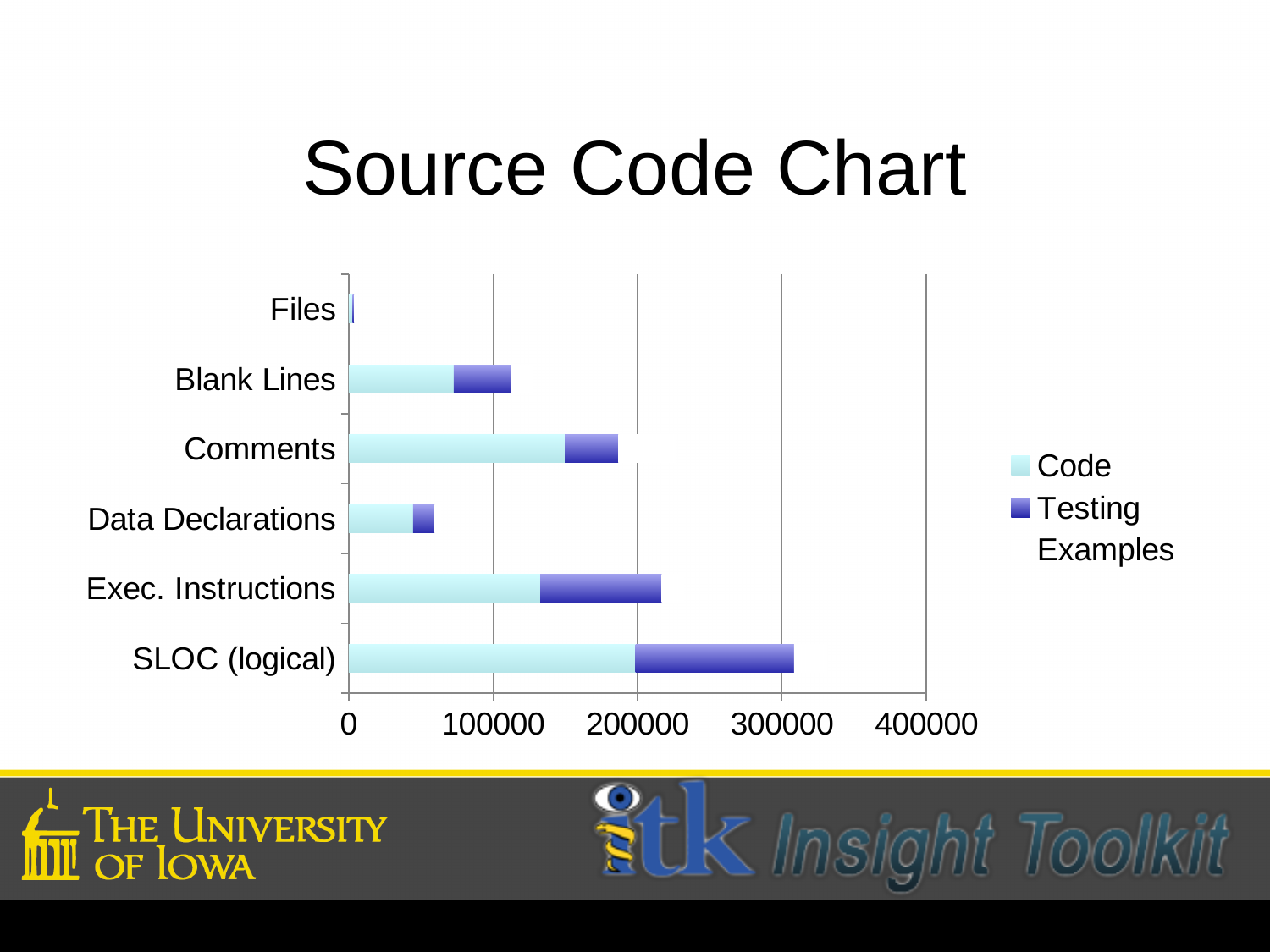
Which category has the shortest total bar? Files Which series is shown in dark blue in the legend? Testing Is the Code value for Comments greater or less than 100000? greater Which category has the longest total bar? SLOC (logical) Is the total value for Data Declarations greater or less than 100000? less How many series does the legend list? 3 How many categories are plotted on the chart? 6 What is the title of the chart? Source Code Chart Which has the larger total bar, Comments or Blank Lines? Comments Is the total value for SLOC (logical) greater or less than 200000? greater What kind of chart is shown on the slide? Stacked bar chart